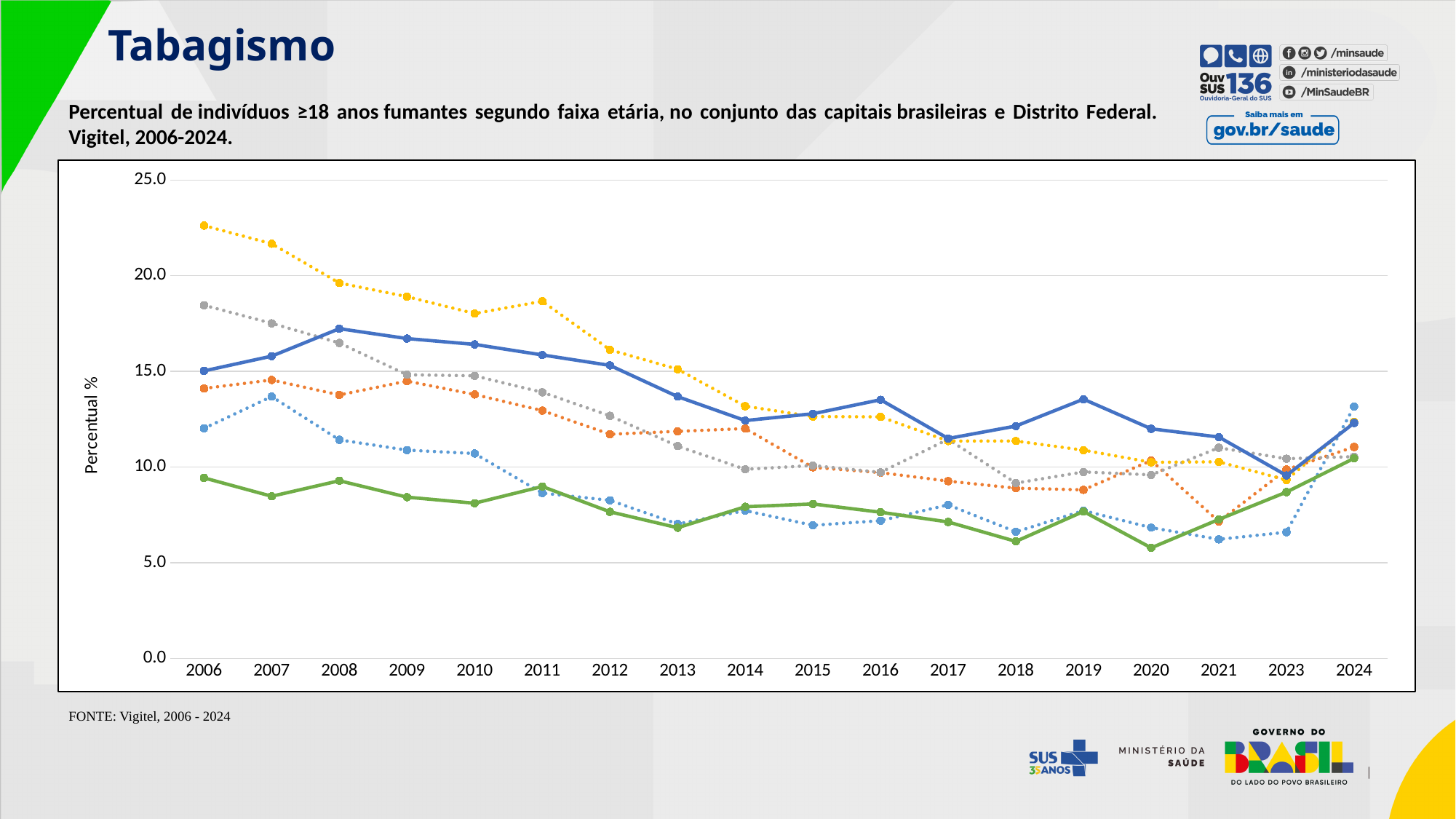
In 2006, which is higher: the yellow dotted line or the green solid line? the yellow dotted line What source is cited below the chart? FONTE: Vigitel, 2006 - 2024 How many years are shown on the x axis of the chart? 18 Is the value of the grey dotted line in 2014 greater or less than 15.0? less Is the value of the green solid line in 2020 greater or less than 10.0? less What is the label of the y axis of the chart? Percentual % Is the value of the yellow dotted line in 2006 greater or less than 20.0? greater Which line has the lowest value in 2006? the green solid line What kind of chart is shown on the slide? line chart Which line has the highest value in 2006? the yellow dotted line Does the yellow dotted line rise or fall from 2006 to 2023? fall